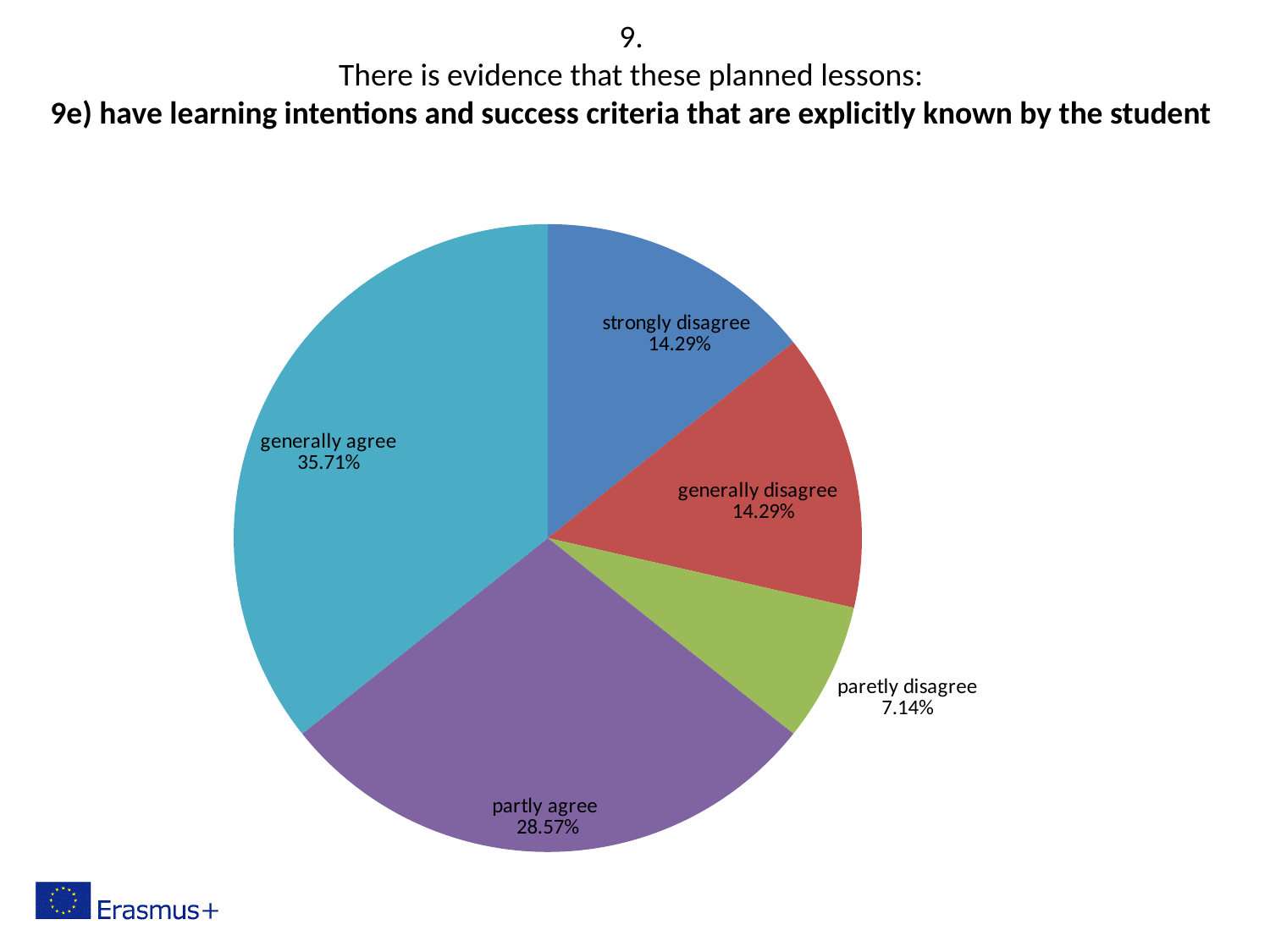
What is the combined percentage of 'strongly disagree' and 'generally disagree'? 28.58% How many slices does the pie chart have? 5 What colour is the 'generally agree' slice? teal/light blue Which response category has the smallest share of the pie? paretly disagree What percentage of responses are 'paretly disagree'? 7.14% Which is larger, the share for 'partly agree' or the share for 'generally disagree'? partly agree What percentage of responses are 'strongly disagree'? 14.29% What is the difference in percentage points between 'generally agree' and 'partly agree'? 7.14 What kind of chart is shown on the slide? pie chart What percentage of responses are 'generally agree'? 35.71% Which response category has the largest share of the pie? generally agree What percentage of responses are 'partly agree'? 28.57%